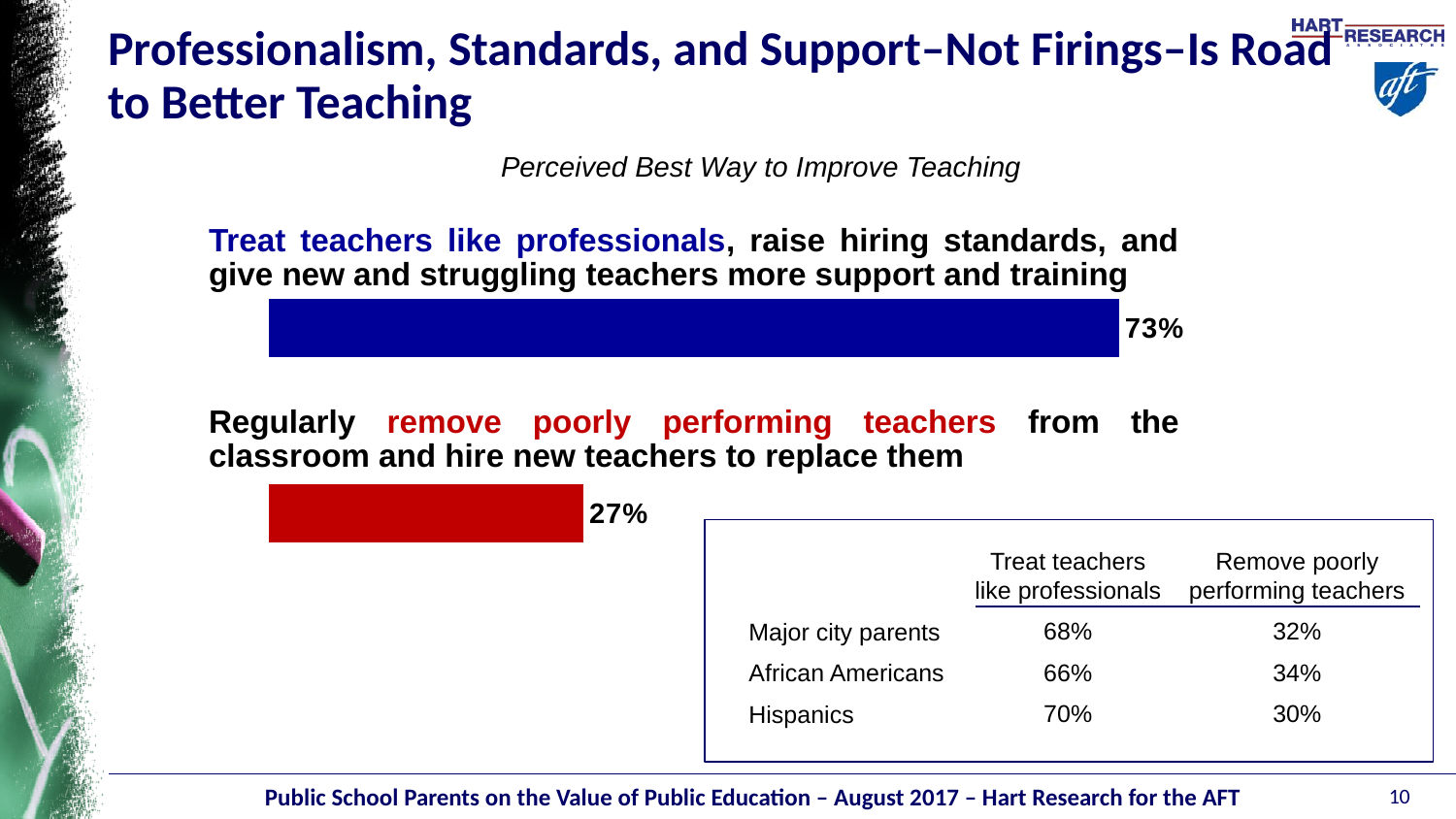
What percentage of parents say treating teachers like professionals, raising hiring standards, and giving more support and training is the best way to improve teaching? 73% Is the value for 'treat teachers like professionals' greater or less than 50%? greater How many bars are shown in the chart? 2 What is the difference in percentage points between the 'treat teachers like professionals' bar and the 'remove poorly performing teachers' bar? 46 percentage points Which option has the higher percentage in the bar chart: treating teachers like professionals or removing poorly performing teachers? Treat teachers like professionals Which option has the lower percentage in the bar chart? Remove poorly performing teachers What is the subtitle of the chart? Perceived Best Way to Improve Teaching What percentage of parents say regularly removing poorly performing teachers and hiring new teachers to replace them is the best way to improve teaching? 27% What colour is the bar for 'remove poorly performing teachers'? Red What do the two bars in the chart add up to? 100% What type of chart is used to show the perceived best way to improve teaching? Bar chart Is the value for 'remove poorly performing teachers' larger or smaller than the value for 'treat teachers like professionals'? Smaller